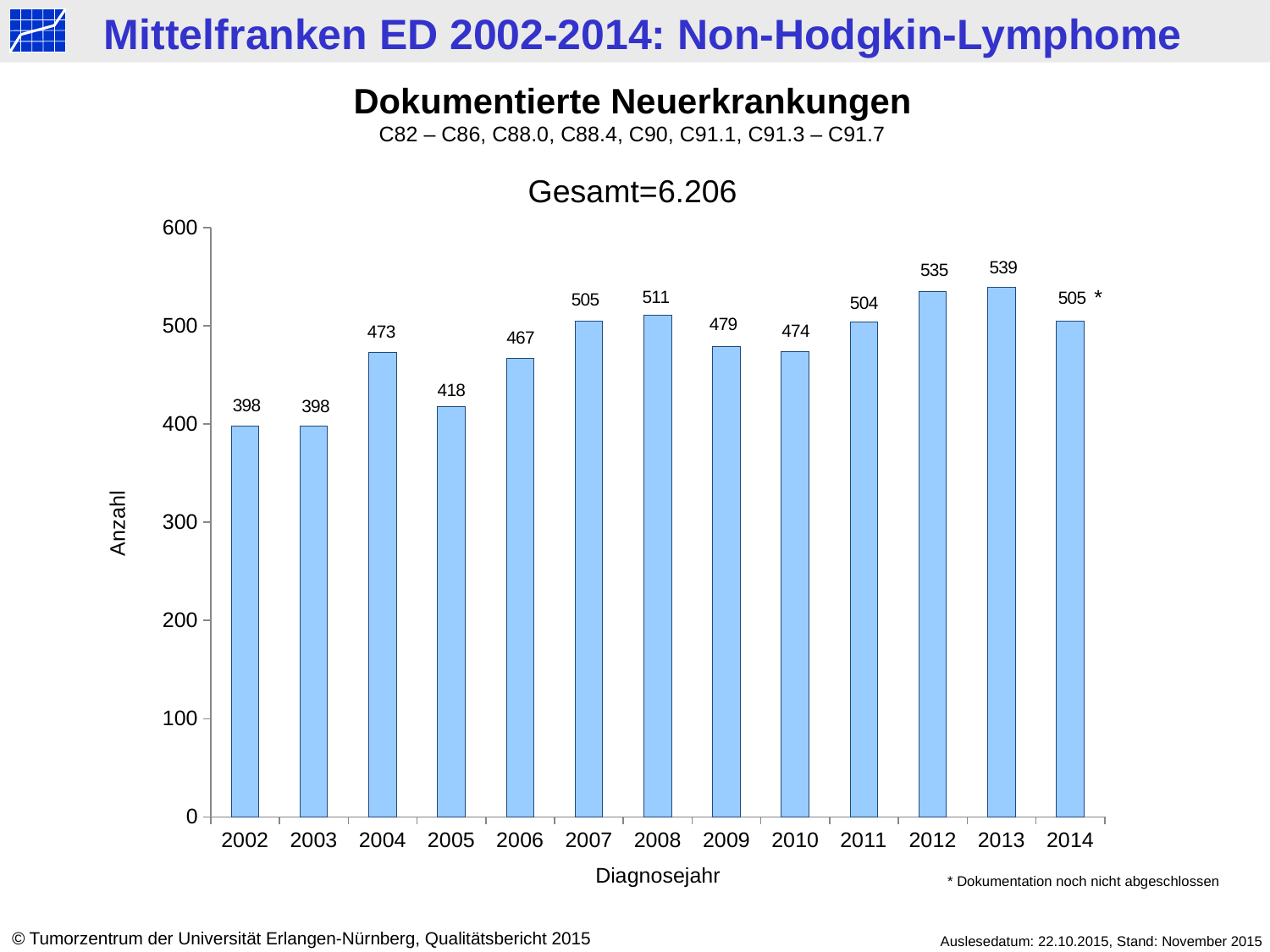
What is the value shown for 2005? 418 Do the values rise or fall from 2002 to 2004? rise Is the value for 2012 greater or less than 500? greater How many years are shown on the x axis? 13 What is the difference between the values for 2013 and 2002? 141 What is the number of documented new cases for 2008? 511 What kind of chart is shown on the slide? bar chart Which years share the lowest value on the chart? 2002 and 2003 What total (Gesamt) is stated above the chart? 6.206 Which year has the larger value, 2004 or 2006? 2004 What is the label of the y axis? Anzahl Which year has the highest number of documented new cases? 2013